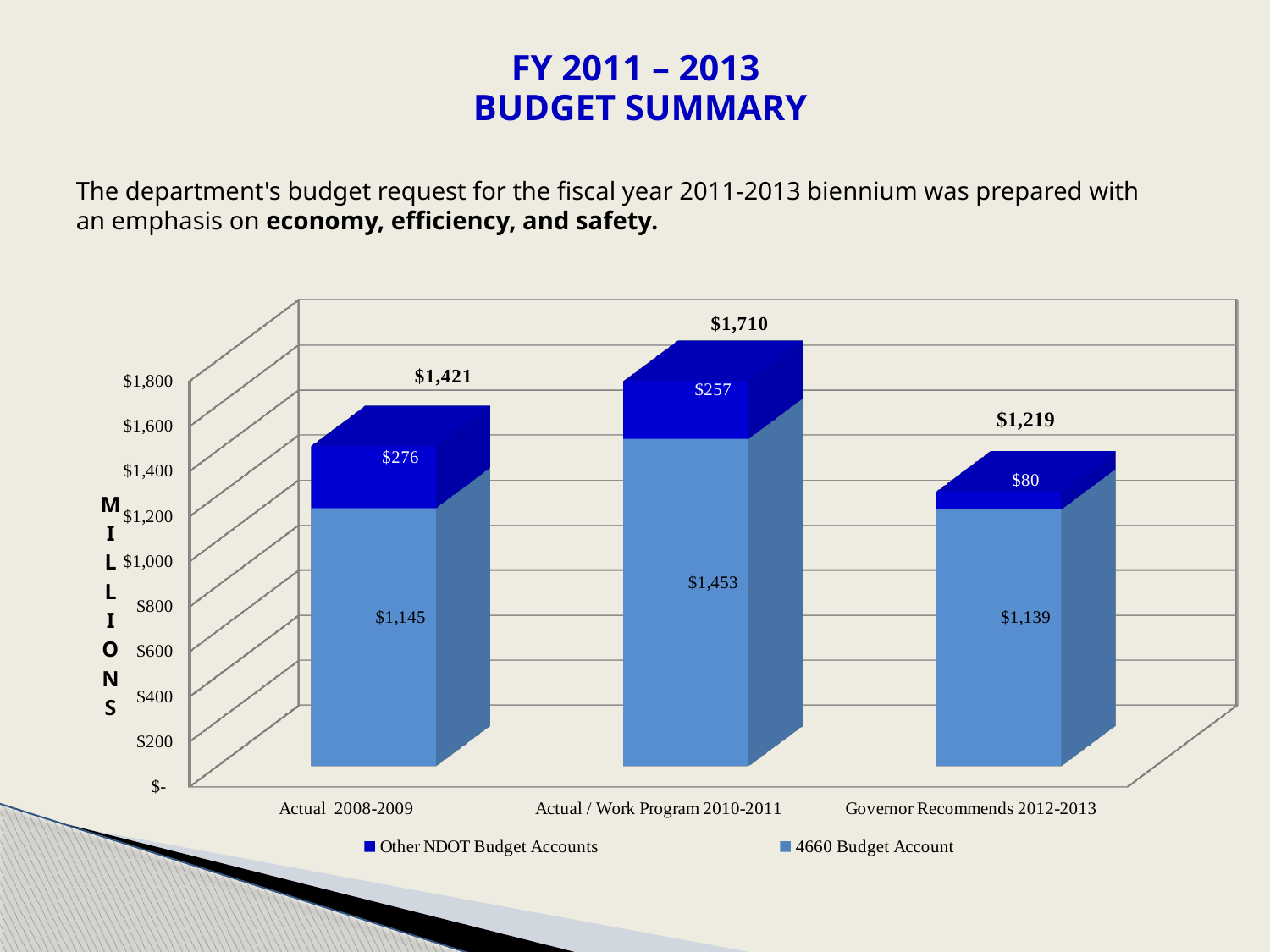
Which category has the highest total? Actual / Work Program 2010-2011 What is the value of Other NDOT Budget Accounts for Governor Recommends 2012-2013? $80 How many categories are shown on the x axis? 3 What is the value of the 4660 Budget Account for Actual 2008-2009? $1,145 What is the difference between the 4660 Budget Account values for Actual / Work Program 2010-2011 and Governor Recommends 2012-2013? $314 Which is larger: the 4660 Budget Account value for Actual 2008-2009 or for Governor Recommends 2012-2013? Actual 2008-2009 What kind of chart is shown on the slide? Stacked bar chart What is the value of Other NDOT Budget Accounts for Actual / Work Program 2010-2011? $257 What is the total of the stacked bar for Actual / Work Program 2010-2011? $1,710 What is the total of the stacked bar for Governor Recommends 2012-2013? $1,219 Which category has the lowest value for Other NDOT Budget Accounts? Governor Recommends 2012-2013 How many series does the legend list? 2